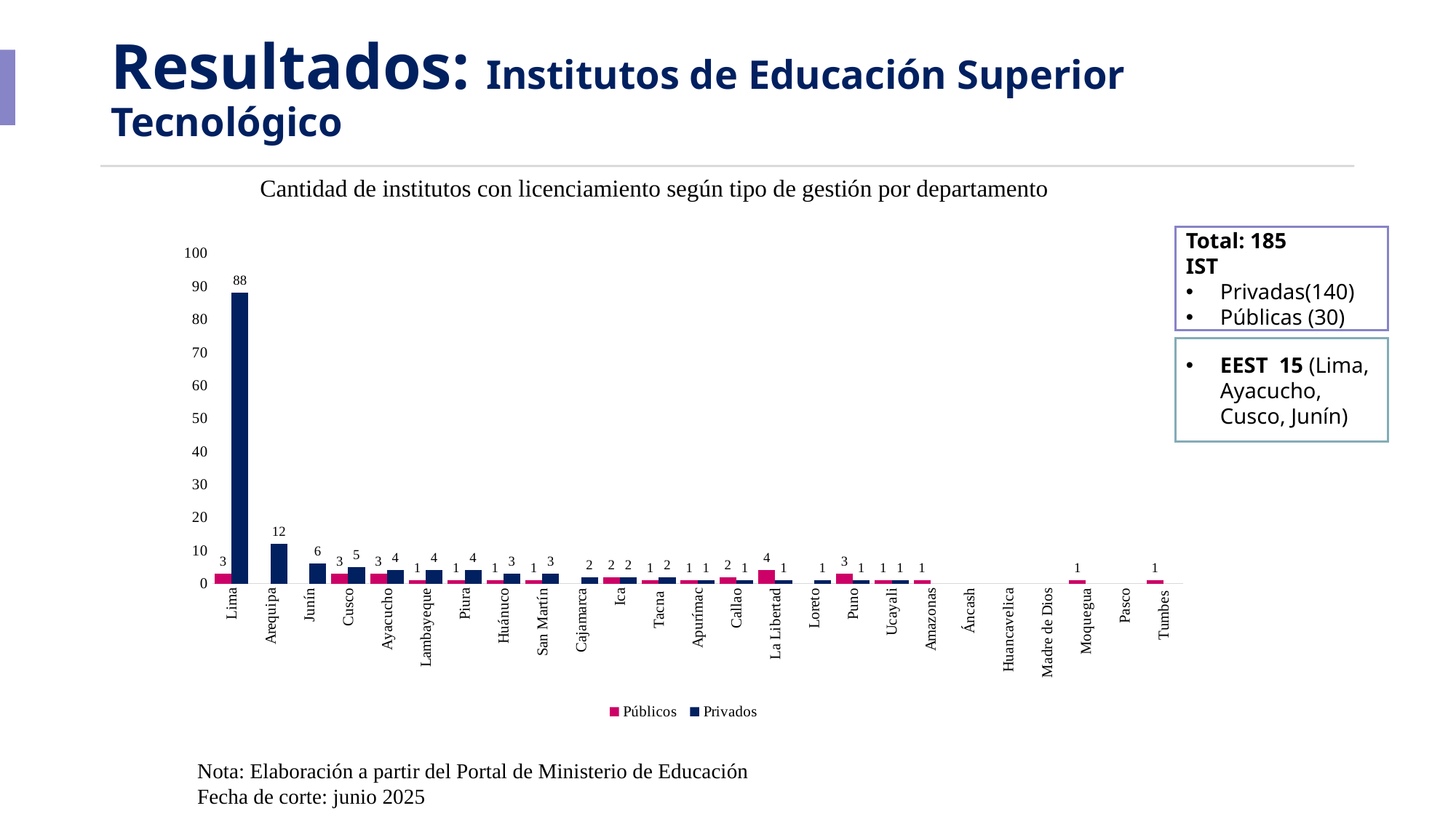
What is the title of the chart? Cantidad de institutos con licenciamiento según tipo de gestión por departamento What is the value for Privados in Lima? 88 What is the value for Públicos in La Libertad? 4 Which department has the highest value for Públicos? La Libertad In Cusco, which is larger: Públicos or Privados? Privados What is the value for Privados in Junín? 6 Which department has the highest value for Privados? Lima How many series does the legend list? 2 What is the value for Privados in Arequipa? 12 What is the difference between Privados and Públicos in Lima? 85 What kind of chart is shown on the slide? Bar chart Is the value for Privados in Lima greater or less than 80? greater